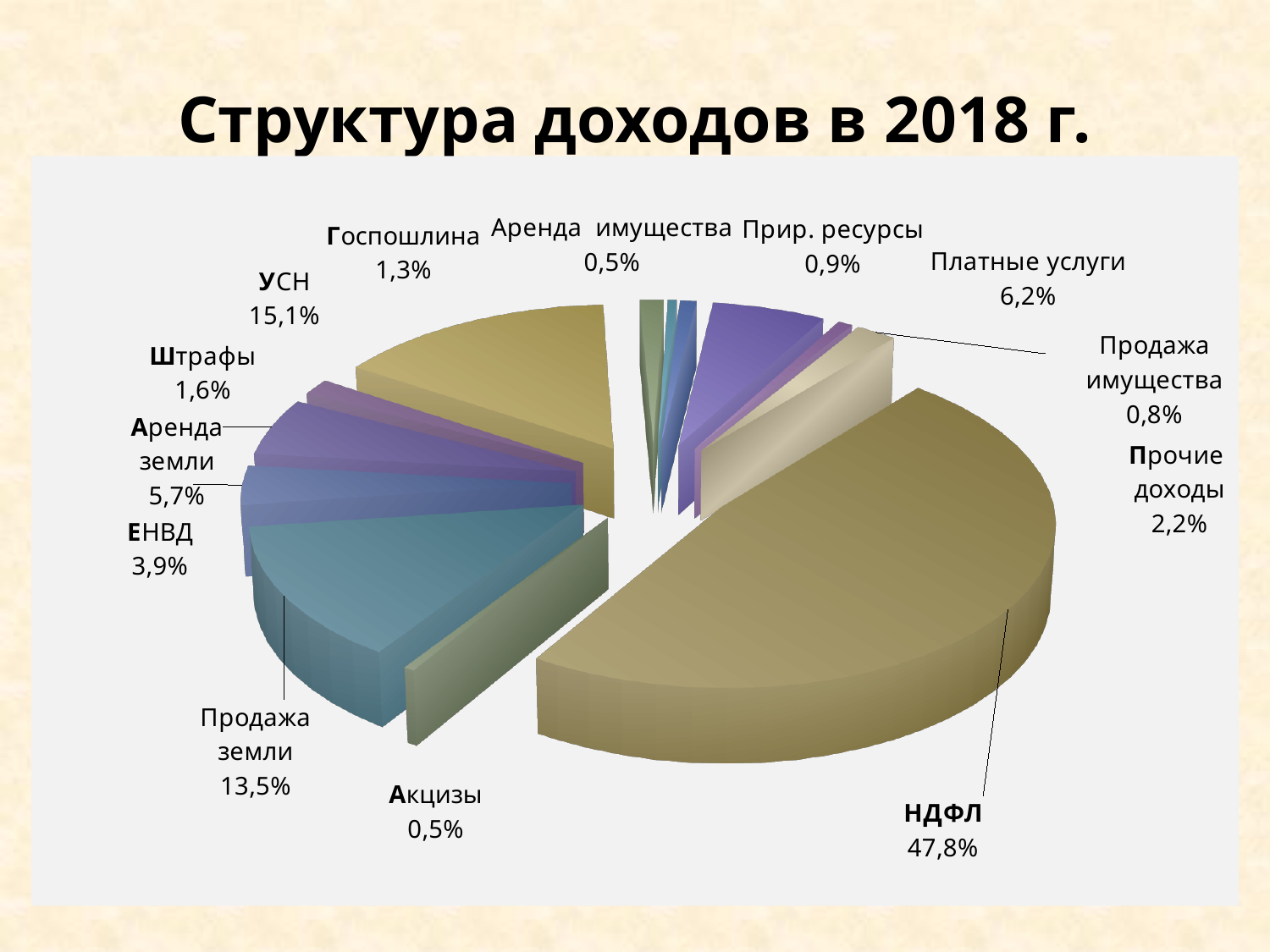
What is the difference between the shares of НДФЛ and УСН? 32,7% What share of income does НДФЛ account for? 47,8% What is the value for Платные услуги? 6,2% What is the difference between the shares of Аренда земли and ЕНВД? 1,8% What is the value shown for Прочие доходы? 2,2% How many categories are shown in the pie chart? 13 What is the title of the chart? Структура доходов в 2018 г. What is the value shown for УСН? 15,1% Which category has the largest share of the pie? НДФЛ What type of chart is shown on the slide? Pie chart What percentage is shown for Продажа земли? 13,5% Which is larger, the share for УСН or the share for Продажа земли? УСН